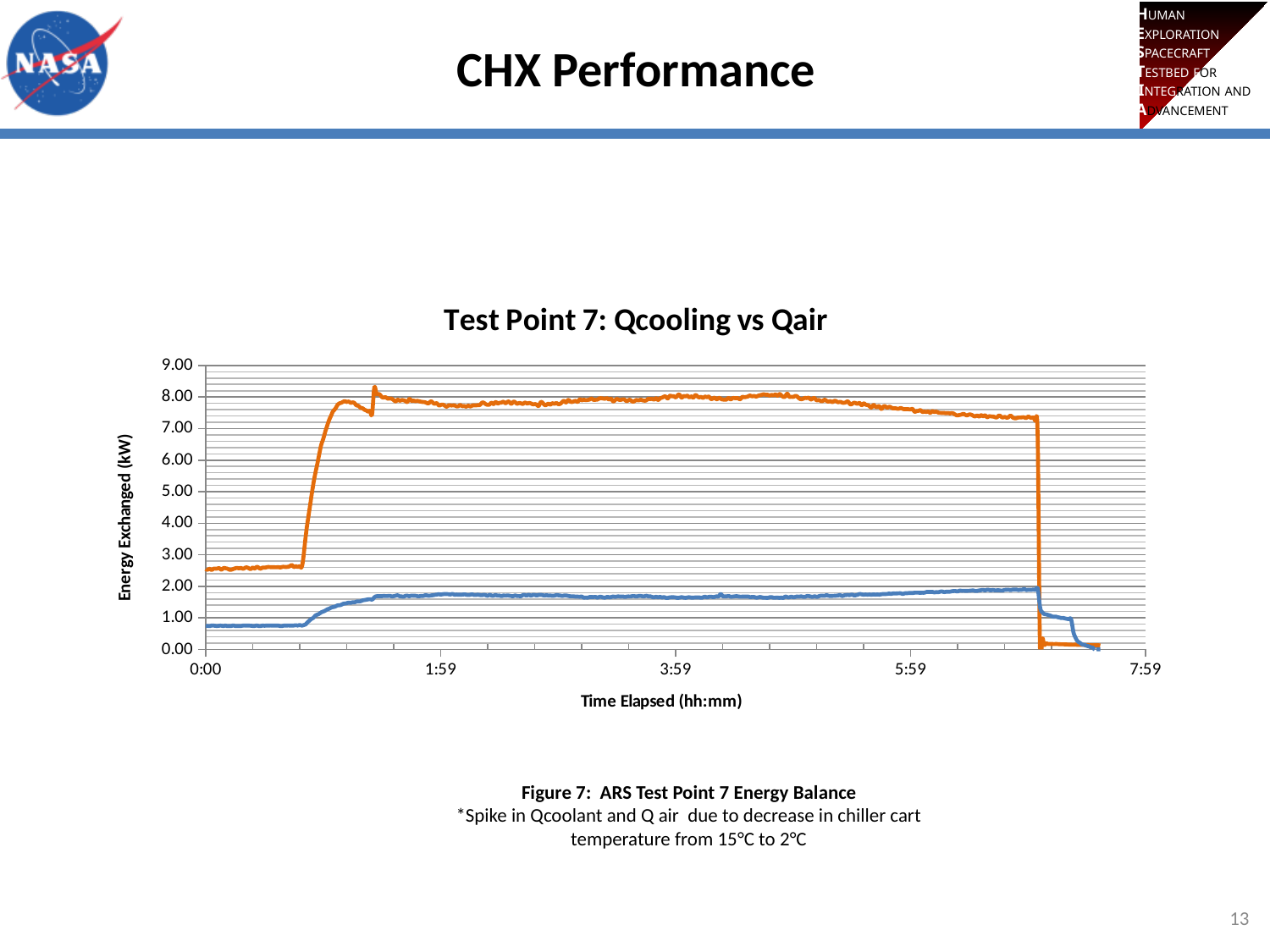
Is the value of the orange line at 5:59 greater or less than 7.00? greater Is the value of the orange line at 3:59 greater or less than 7.00? greater Between 0:00 and 1:59, does the orange line rise or fall? rise At 3:59, which line has the higher value, the orange line or the blue line? the orange line Is the value of the blue line at 0:00 greater or less than 1.00? less What is the label of the vertical axis of the chart? Energy Exchanged (kW) How many lines are plotted on the chart? 2 What is the title of the chart? Test Point 7: Qcooling vs Qair What kind of chart is shown on the slide? line chart